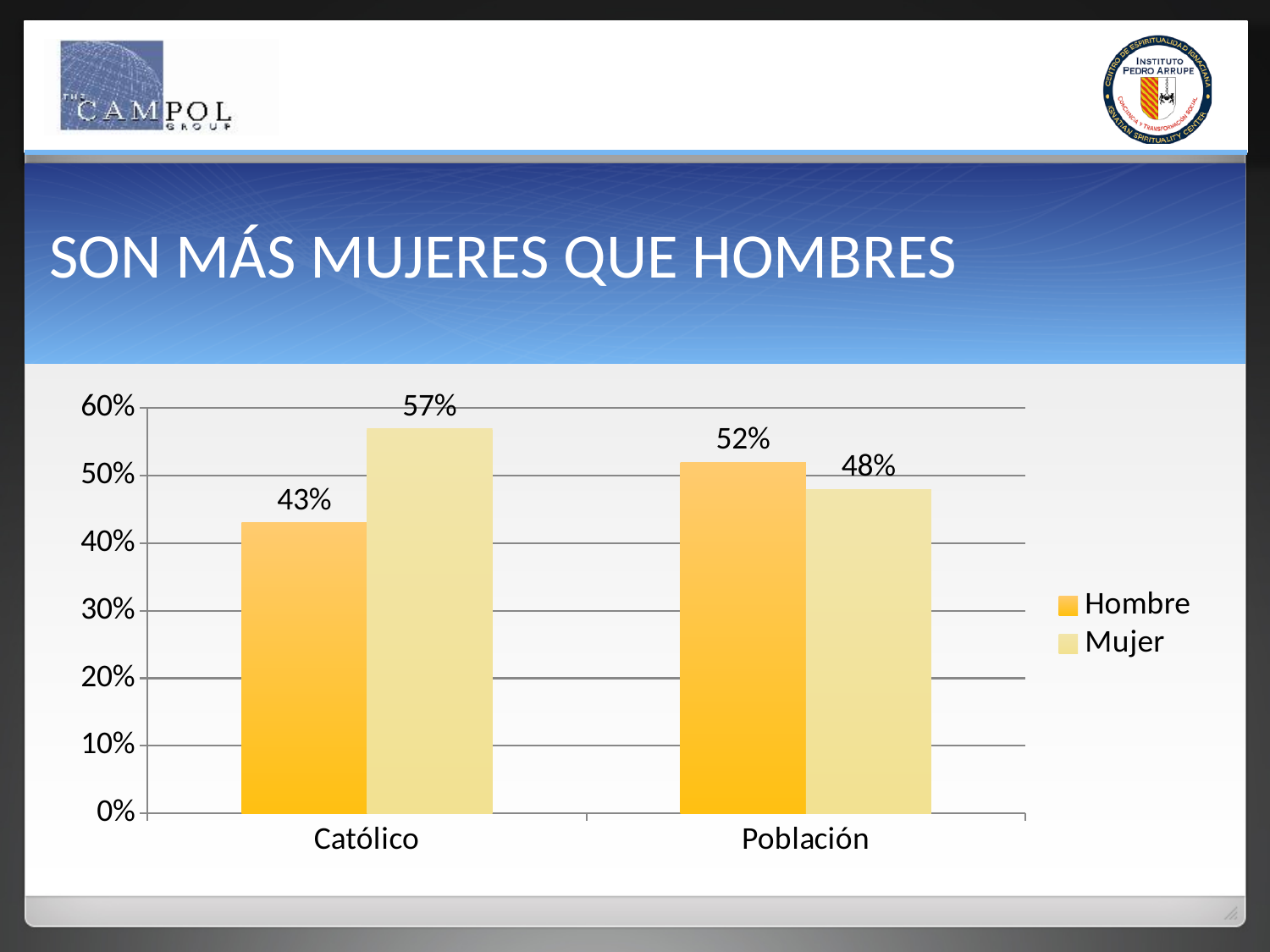
Is the value for Hombre in Católico greater or less than 50%? less Which bar has the highest value on the chart? Mujer, Católico What is the difference between the Mujer and Hombre values in the Católico category? 14% Which is larger in the Población category, Hombre or Mujer? Hombre What is the value for Hombre in the Población category? 52% How many series does the legend list? 2 How many categories are shown on the x axis? 2 What is the value for Mujer in the Población category? 48% Which bar has the lowest value on the chart? Hombre, Católico What is the value for Mujer in the Católico category? 57% What kind of chart is shown on the slide? bar chart What is the value for Hombre in the Católico category? 43%